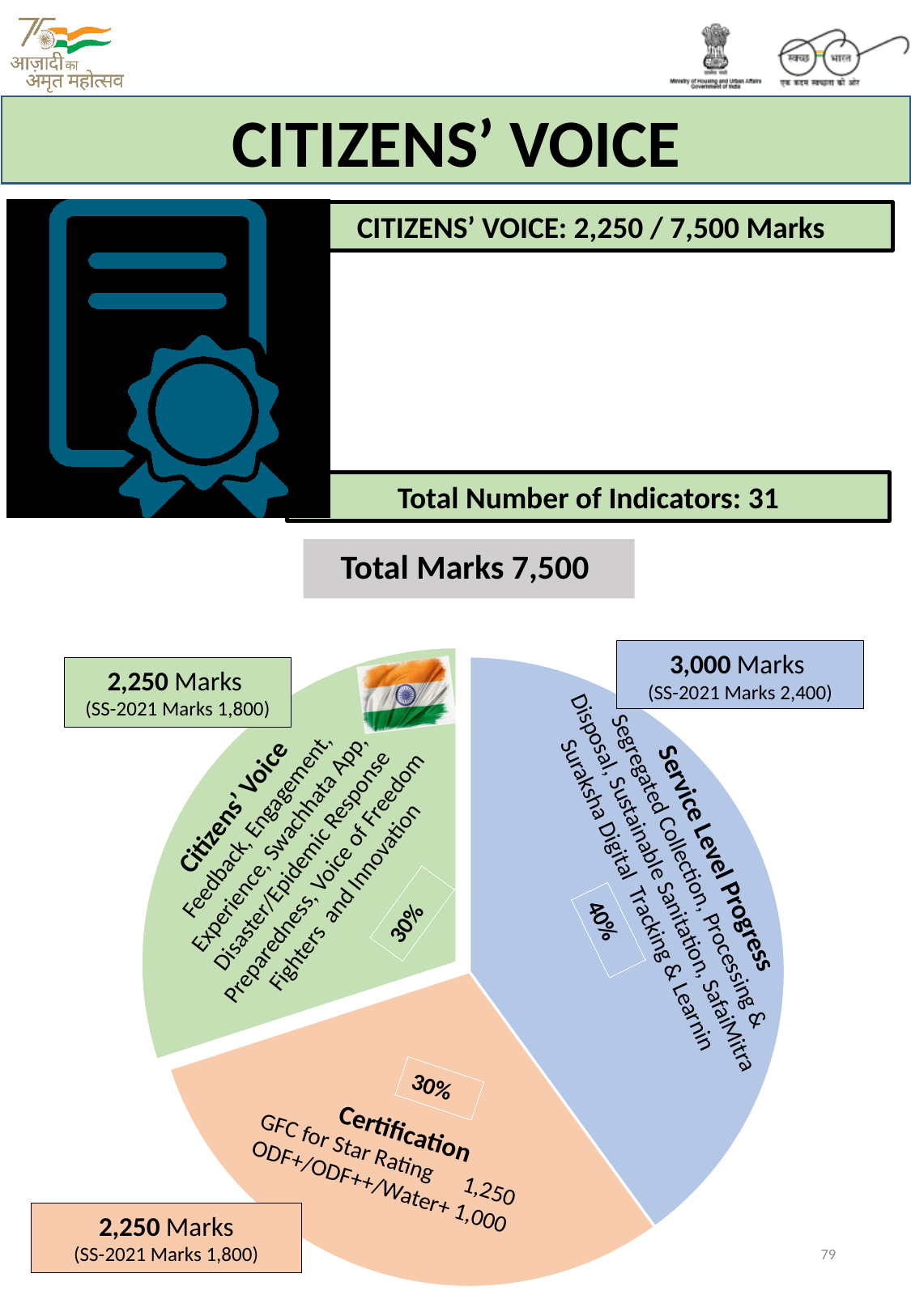
Which slice of the pie chart is the largest? Service Level Progress What kind of chart is shown on the slide? pie chart What colour is the Certification slice of the pie chart? orange How many slices does the pie chart have? 3 How many marks are allocated to Certification? 2,250 Marks What percentage share does the Service Level Progress slice have? 40% How many marks are allocated to Service Level Progress? 3,000 Marks What were the SS-2021 marks for Service Level Progress? 2,400 What percentage share does the Citizens' Voice slice have? 30% What is the difference in marks between Service Level Progress and Citizens' Voice? 750 Which has a larger share of the pie, Service Level Progress or Certification? Service Level Progress What percentage share does the Certification slice have? 30%